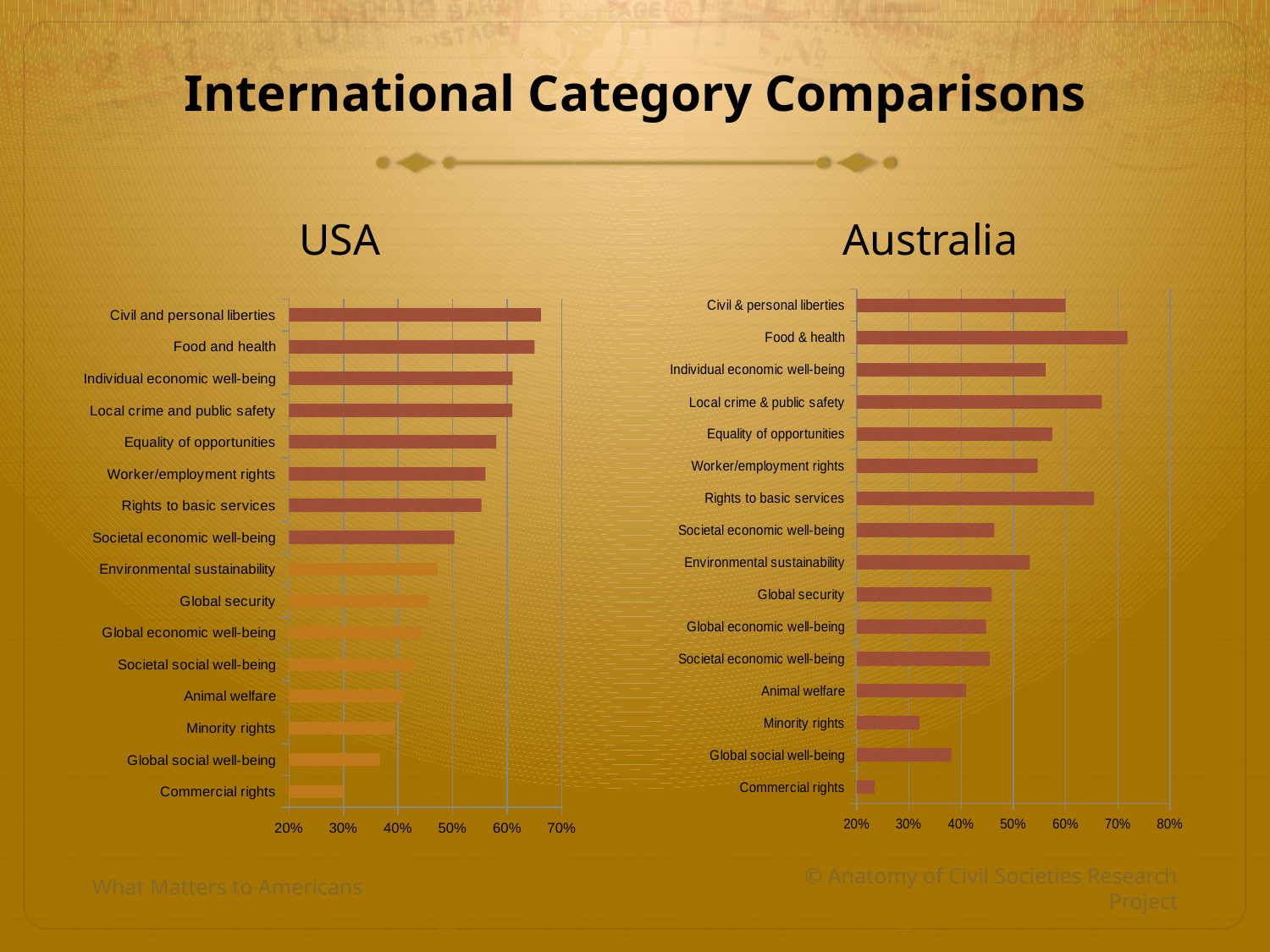
How many categories are shown in the Australia chart? 16 What kind of chart is the USA chart? Bar chart In the Australia chart, which is larger: Local crime & public safety or Civil & personal liberties? Local crime & public safety In the USA chart, which is larger: Civil and personal liberties or Societal economic well-being? Civil and personal liberties In the USA chart, is the value for Global social well-being greater or less than 40%? less In the Australia chart, which category has the highest value? Food & health In the USA chart, is the value for Food and health greater or less than 60%? greater In the Australia chart, which category has the lowest value? Commercial rights In the Australia chart, is the value for Food & health greater or less than 70%? greater What is the title of the slide containing the two charts? International Category Comparisons In the USA chart, which category has the lowest value? Commercial rights